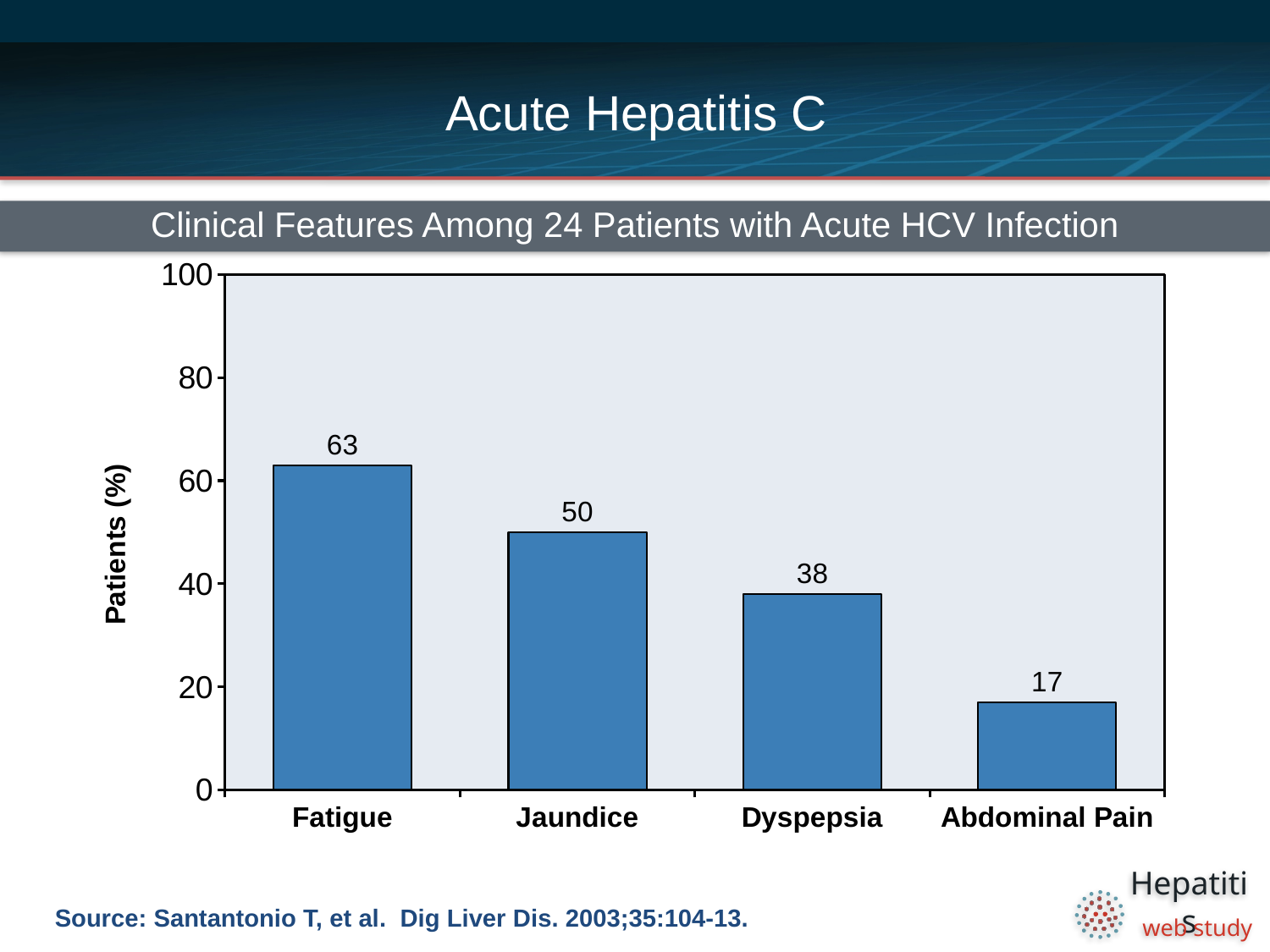
How many clinical features are shown in the chart? 4 Which clinical feature was least common among the patients? Abdominal Pain What percentage of patients had dyspepsia? 38 What percentage of patients had fatigue? 63 Which clinical feature was most common among the patients? Fatigue What is the label of the y-axis? Patients (%) Which was more common, jaundice or dyspepsia? Jaundice Is the value for Dyspepsia greater or less than 40? less What percentage of patients had abdominal pain? 17 What is the difference in percentage points between fatigue and abdominal pain? 46 What type of chart is shown on the slide? Bar chart What percentage of patients had jaundice? 50